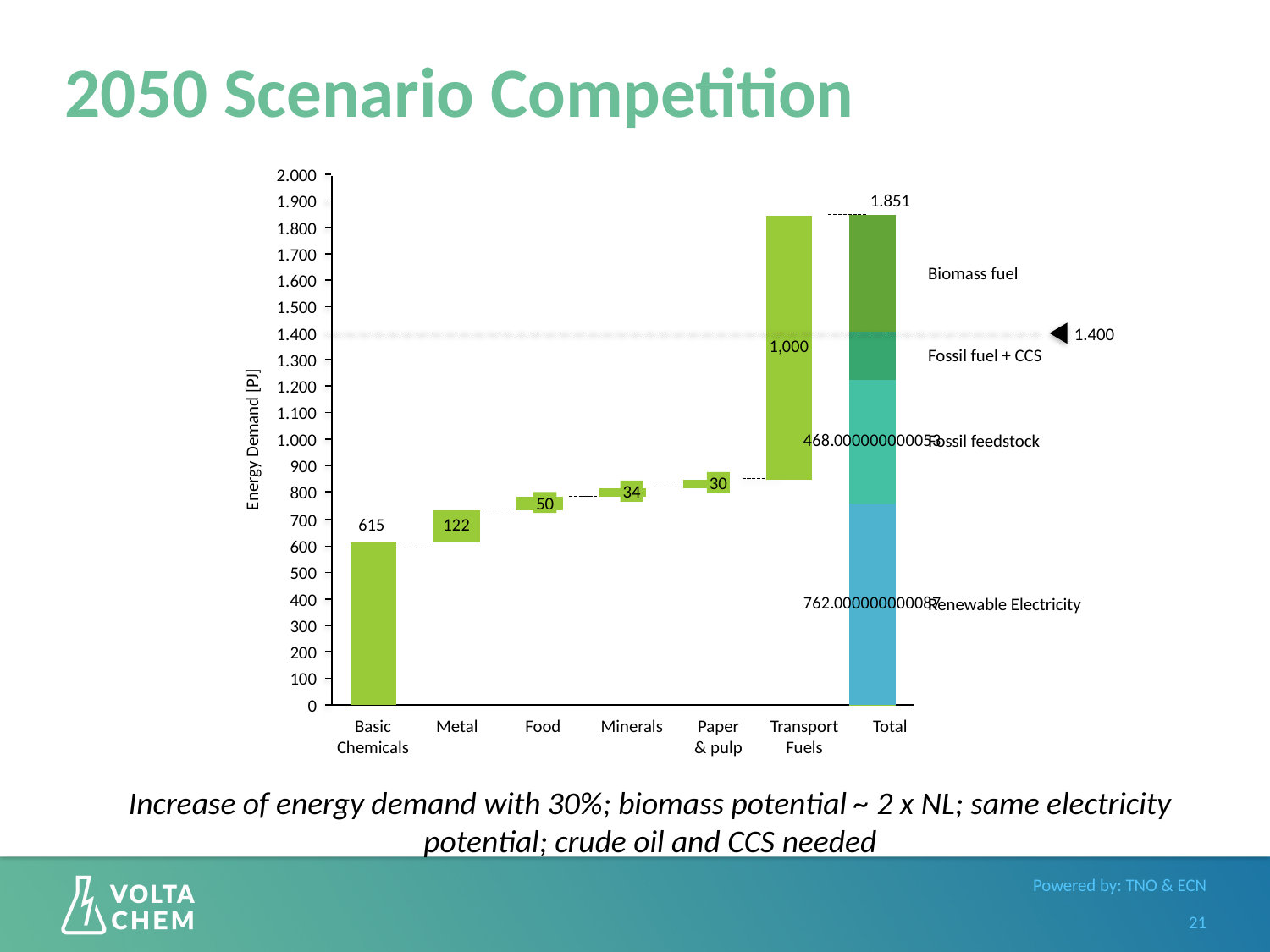
What is the value for Basic Chemicals? 615 Which category has the lowest value? Paper & pulp What is the difference between the Transport Fuels value and the Basic Chemicals value? 385 What is the value labelled on the Total bar? 1.851 What is the value for Metal? 122 What is the y-axis title of the chart? Energy Demand [PJ] How many categories are shown on the x axis? 7 What is the value for Transport Fuels? 1,000 Is the Total bar greater or less than 1.400? greater Which sector category (excluding Total) has the highest value? Transport Fuels Which is larger, the value for Basic Chemicals or the value for Metal? Basic Chemicals What is the difference between the Metal value and the Food value? 72